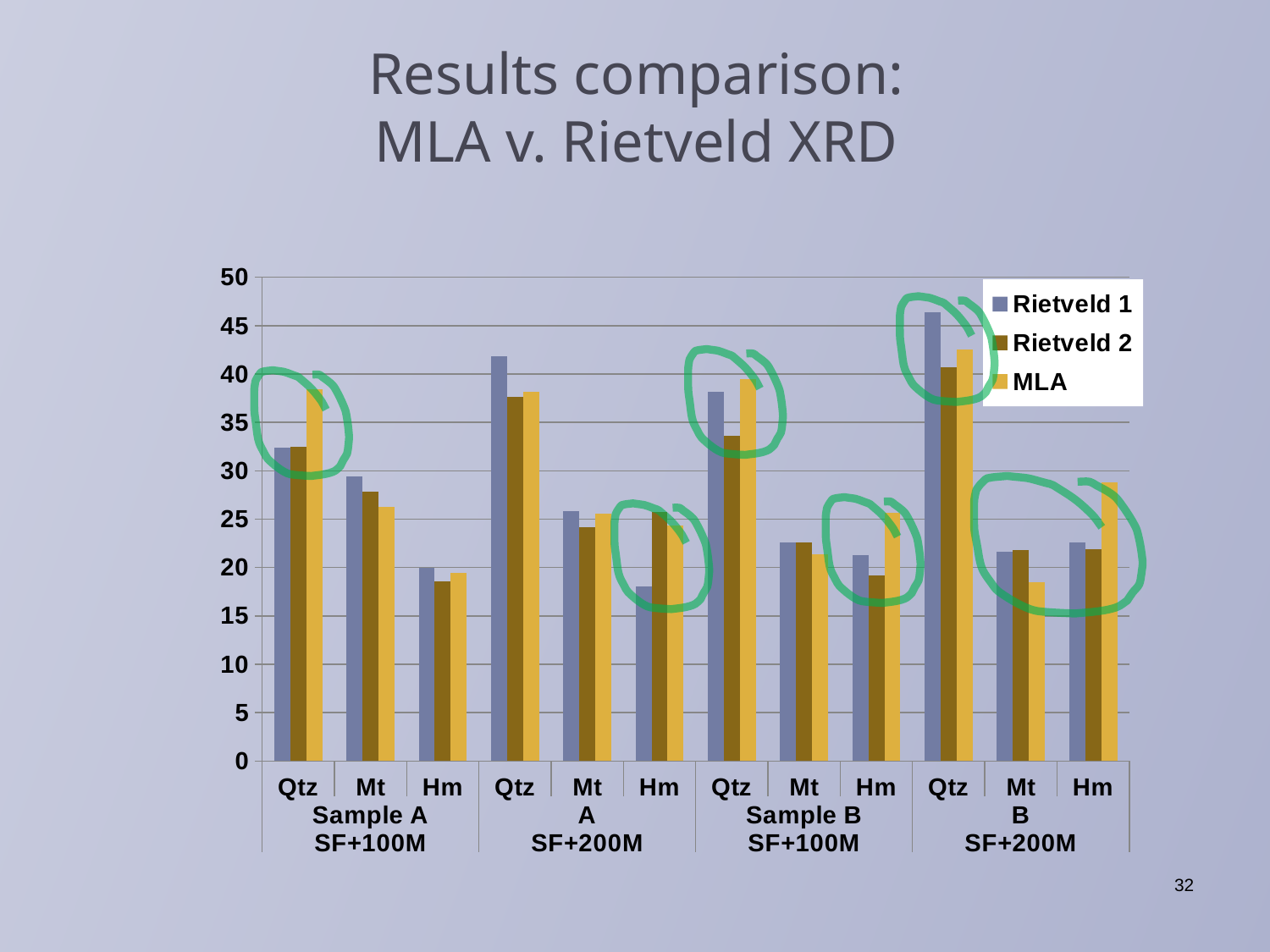
Is the Rietveld 1 value for Qtz in A SF+200M greater or less than 40? greater How many mineral categories (bar groups) are plotted along the x axis? 12 Which bar is the tallest in the whole chart? Rietveld 1 for Qtz in B SF+200M Is the Rietveld 1 value for Hm in A SF+200M greater or less than 20? less What is the title of the slide containing the chart? Results comparison: MLA v. Rietveld XRD For Hm in Sample B SF+100M, which series has the highest value? MLA What kind of chart is shown on the slide? Bar chart For Hm in A SF+200M, which is larger: Rietveld 1 or Rietveld 2? Rietveld 2 For Qtz in Sample A SF+100M, which is larger: the MLA value or the Rietveld 1 value? MLA Which series is shown in yellow/gold bars? MLA How many series does the legend list? 3 Is the Rietveld 1 value for Qtz in B SF+200M greater or less than 45? greater